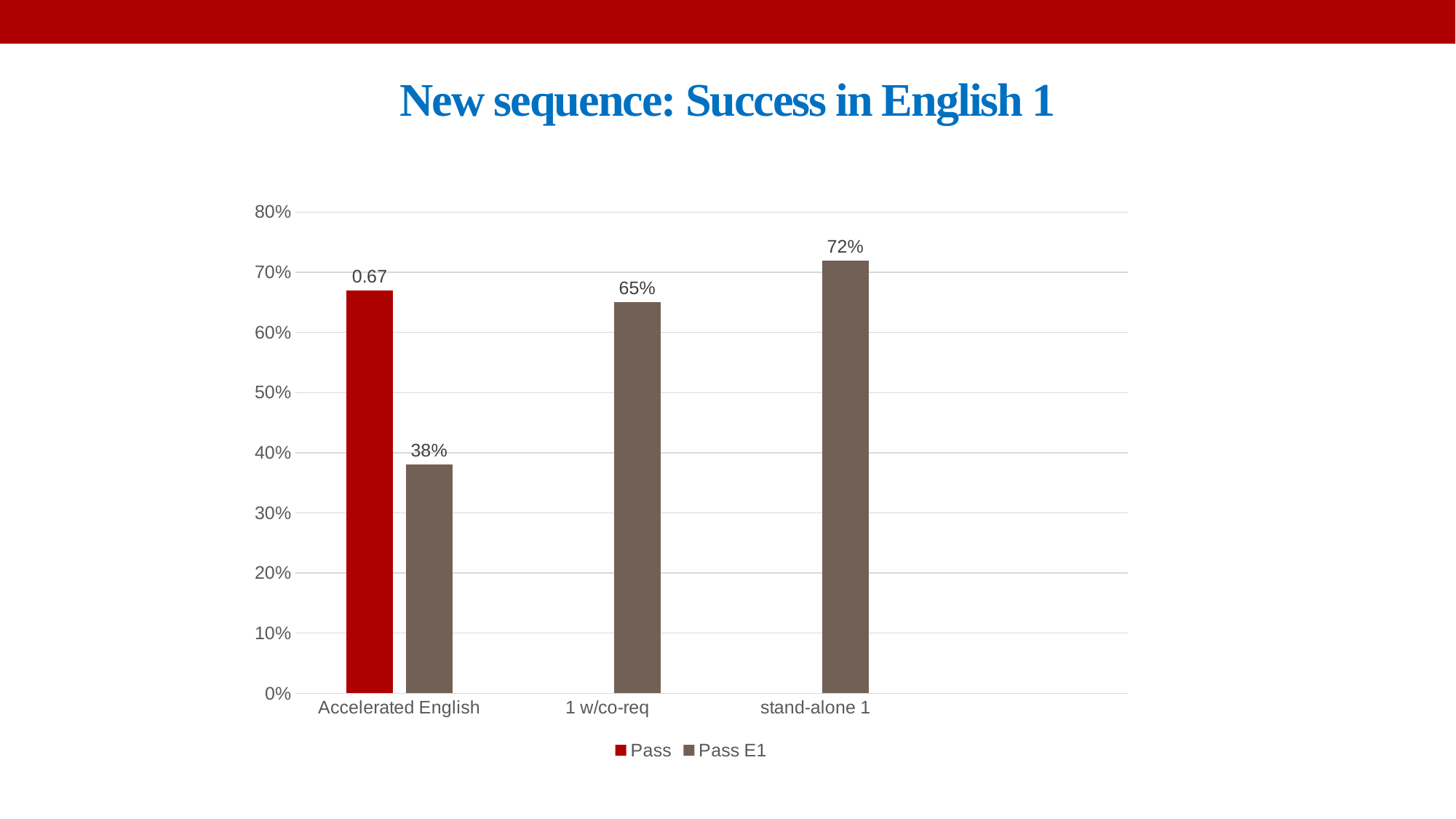
What is the Pass E1 value for Accelerated English? 38% What is the Pass E1 value for stand-alone 1? 72% What type of chart is shown on the slide? bar chart Which category has the highest Pass E1 value? stand-alone 1 How many series does the legend list? 2 What is the Pass E1 value for 1 w/co-req? 65% What data label is shown on the Pass bar for Accelerated English? 0.67 How many categories are shown on the x axis? 3 Which is larger: the Pass E1 value for 1 w/co-req or for Accelerated English? 1 w/co-req What is the difference between the Pass E1 values for stand-alone 1 and 1 w/co-req? 7% Which category has the lowest Pass E1 value? Accelerated English Is the Pass E1 value for Accelerated English greater or less than 40%? less